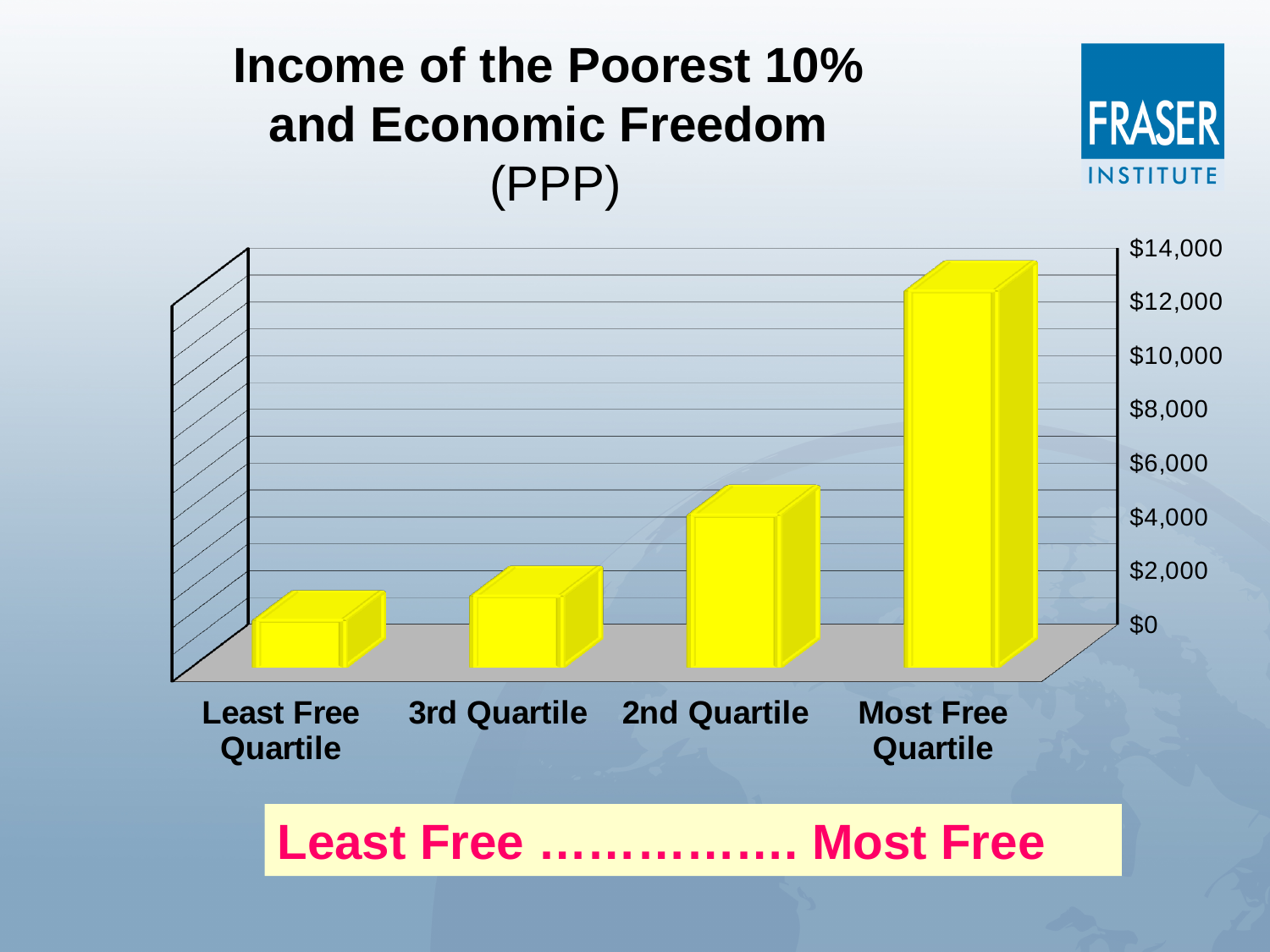
Which quartile has the highest income of the poorest 10%? Most Free Quartile What kind of chart is shown on the slide? bar chart How many quartile categories are plotted in the chart? 4 What is the title of the chart on the slide? Income of the Poorest 10% and Economic Freedom (PPP) Do the bar values rise or fall moving from the Least Free Quartile to the Most Free Quartile? rise Which quartile has the lowest income of the poorest 10%? Least Free Quartile Which is larger, the value for the 2nd Quartile or the value for the 3rd Quartile? 2nd Quartile Is the value for the 2nd Quartile greater or less than $6,000? less Is the value for the 3rd Quartile greater or less than $4,000? less Is the value for the Most Free Quartile greater or less than $10,000? greater